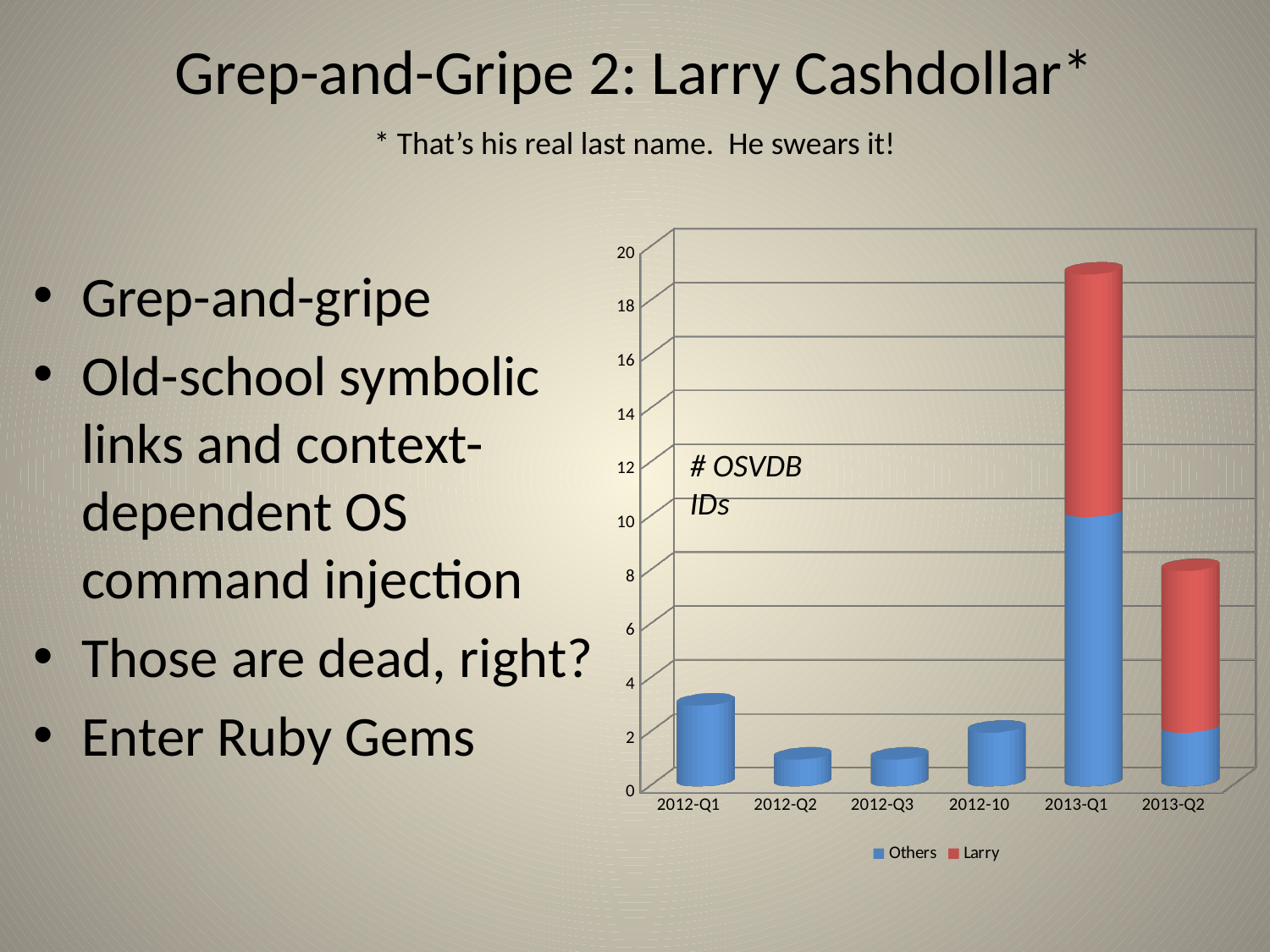
Is the total value for 2013-Q2 greater or less than 6? greater Is the value for 2012-10 greater or less than 4? less Which categories in the chart include a red 'Larry' segment? 2013-Q1 and 2013-Q2 What kind of chart is shown on the slide? Stacked bar chart How many categories are shown along the x axis of the chart? 6 Is the value for 2012-Q1 greater or less than 4? less How many series does the chart legend list? 2 Which has the larger bar, 2012-Q1 or 2012-Q2? 2012-Q1 Which category has the tallest stacked bar in the chart? 2013-Q1 Which has the larger total bar, 2013-Q1 or 2013-Q2? 2013-Q1 What are the two series named in the chart legend? Others and Larry